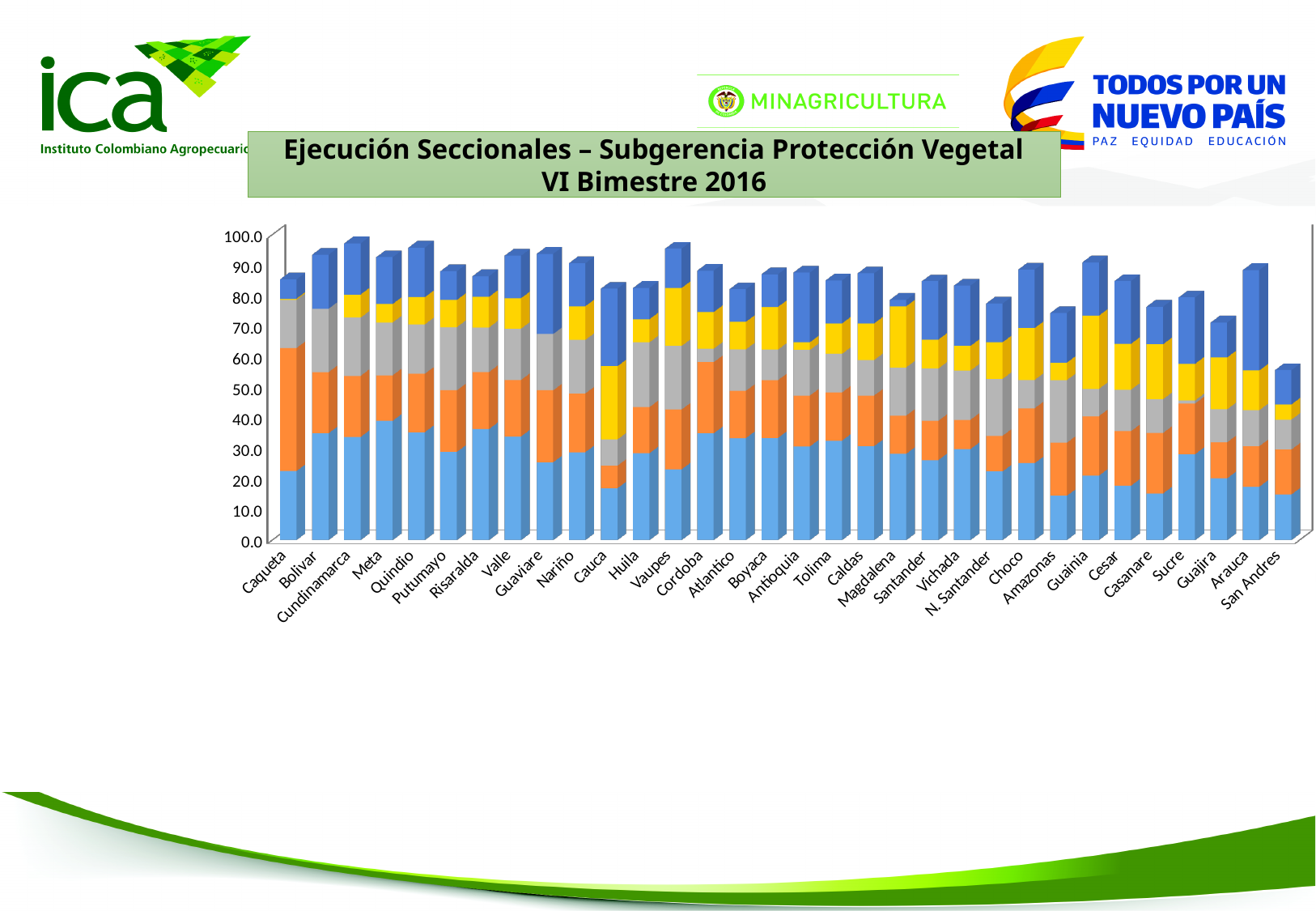
Is the total stacked value for Guajira greater or less than 80.0? less Which department has the tallest stacked bar in the chart? Cundinamarca Which has the taller stacked bar, Cundinamarca or San Andres? Cundinamarca Is the total stacked value for Cundinamarca greater or less than 90.0? greater What kind of chart is shown on the slide? stacked bar chart What is the title of the chart on the slide? Ejecución Seccionales – Subgerencia Protección Vegetal VI Bimestre 2016 Which department has the shortest stacked bar in the chart? San Andres Is the total stacked value for San Andres greater or less than 60.0? less What is the maximum value shown on the vertical axis of the chart? 100.0 How many departments (categories) are shown on the x axis of the chart? 32 Which has the taller stacked bar, Arauca or Guajira? Arauca